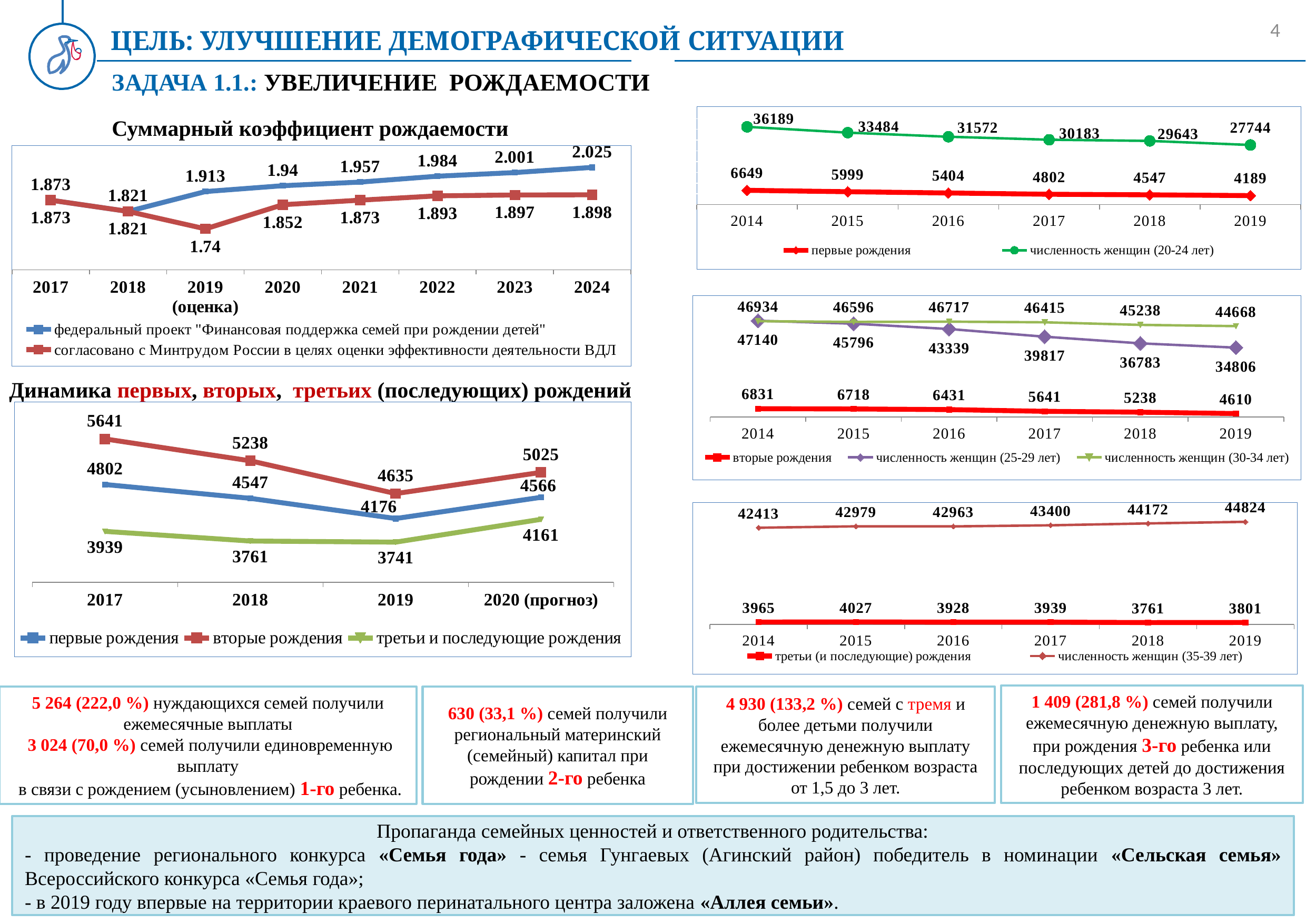
In the chart titled "Суммарный коэффициент рождаемости", how many series does the legend list? 2 In the chart titled "Динамика первых, вторых, третьих (последующих) рождений", what is the value for "вторые рождения" in 2019? 4635 In the top-right chart, what is the value of "численность женщин (20-24 лет)" in 2014? 36189 In the chart titled "Суммарный коэффициент рождаемости", what is the lowest value of the series "согласовано с Минтрудом России в целях оценки эффективности деятельности ВДЛ", and in which year? 1.74 in 2019 In the bottom-right chart, what is the value of "третьи (и последующие) рождения" in 2015? 4027 In the chart titled "Суммарный коэффициент рождаемости", what is the difference between the two series' values in 2024 (оценка)? 0.127 In the top-right chart, does the series "первые рождения" rise or fall from 2014 to 2019? fall In the middle-right chart, which is larger in 2019: "численность женщин (25-29 лет)" or "численность женщин (30-34 лет)"? численность женщин (30-34 лет) What kind of chart is the chart titled "Динамика первых, вторых, третьих (последующих) рождений"? line chart In the chart titled "Динамика первых, вторых, третьих (последующих) рождений", how many years are shown on the x axis? 4 In the chart titled "Суммарный коэффициент рождаемости", what is the value of the series "федеральный проект "Финансовая поддержка семей при рождении детей"" for 2024 (оценка)? 2.025 In the chart titled "Динамика первых, вторых, третьих (последующих) рождений", which series has the highest value in 2017? вторые рождения